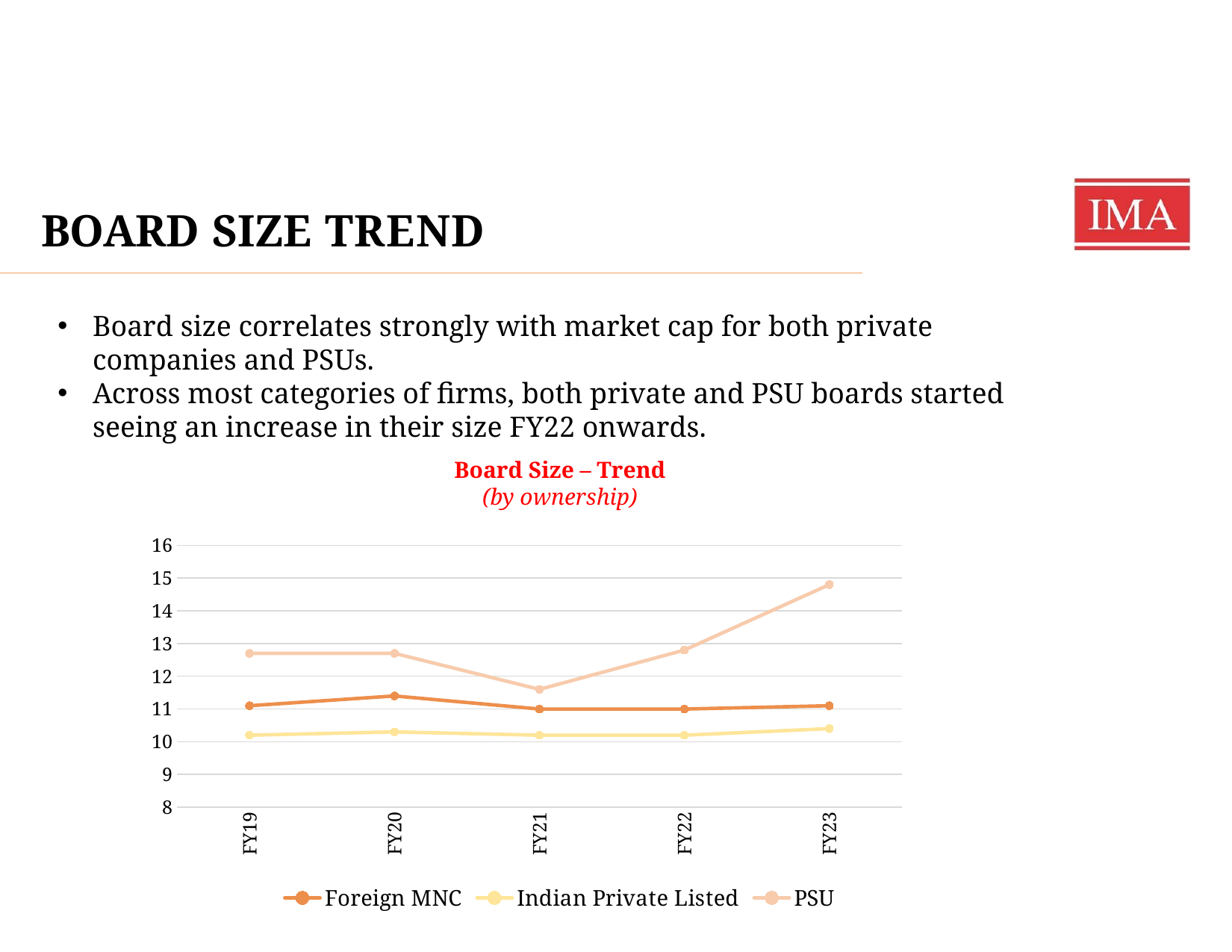
Does the PSU series rise or fall from FY21 to FY23? Rise Is the PSU value for FY21 greater or less than 12? less What is the title of the chart? Board Size – Trend (by ownership) Is the Indian Private Listed value for FY19 greater or less than 11? less How many fiscal years are plotted along the x axis? 5 What kind of chart is shown on the slide? Line chart In which fiscal year does the PSU series reach its highest value? FY23 Is the PSU value for FY23 greater or less than 14? greater In which fiscal year does the PSU series reach its lowest value? FY21 Which series has the highest value in FY23? PSU Which series has the lowest value in FY19? Indian Private Listed How many series does the chart legend list? 3